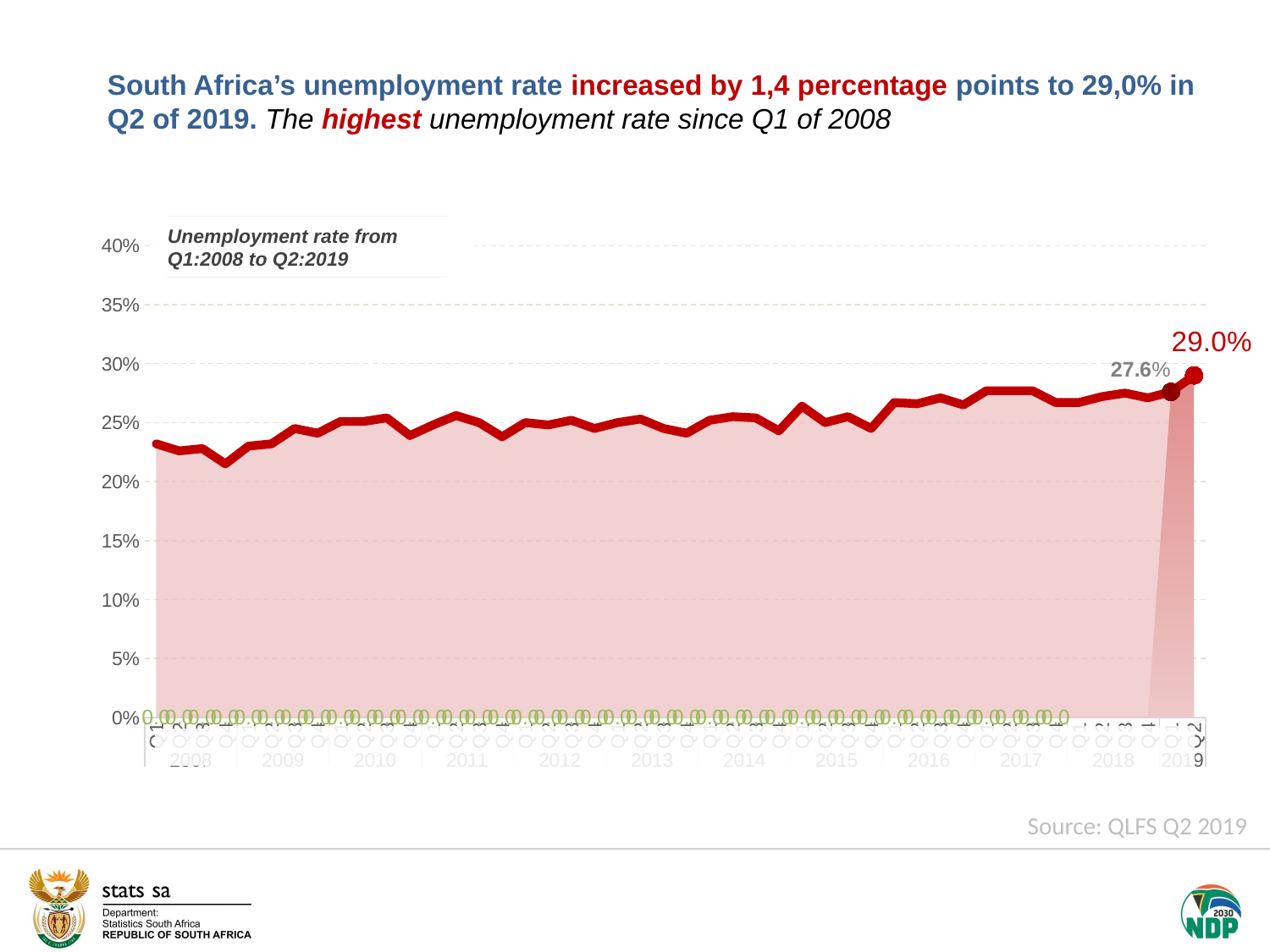
What is the title of the chart? Unemployment rate from Q1:2008 to Q2:2019 By how many percentage points did the unemployment rate change between Q1 2019 and Q2 2019? 1.4 percentage points Is the unemployment rate for Q2 2019 greater or less than 30%? less Does the unemployment rate overall rise or fall from 2008 to 2019? rise In which year does the lowest point of the unemployment rate line occur? 2008 Which quarter has the highest unemployment rate on the chart? Q2 2019 Which is larger, the unemployment rate in Q1 2019 or in Q2 2019? Q2 2019 What is the unemployment rate shown for Q1 of 2019? 27.6% What source is cited for the chart? QLFS Q2 2019 Is the unemployment rate for Q1 2008 greater or less than 25%? less What is the unemployment rate shown for Q2 of 2019? 29.0% How many years are labelled on the x axis of the chart? 12